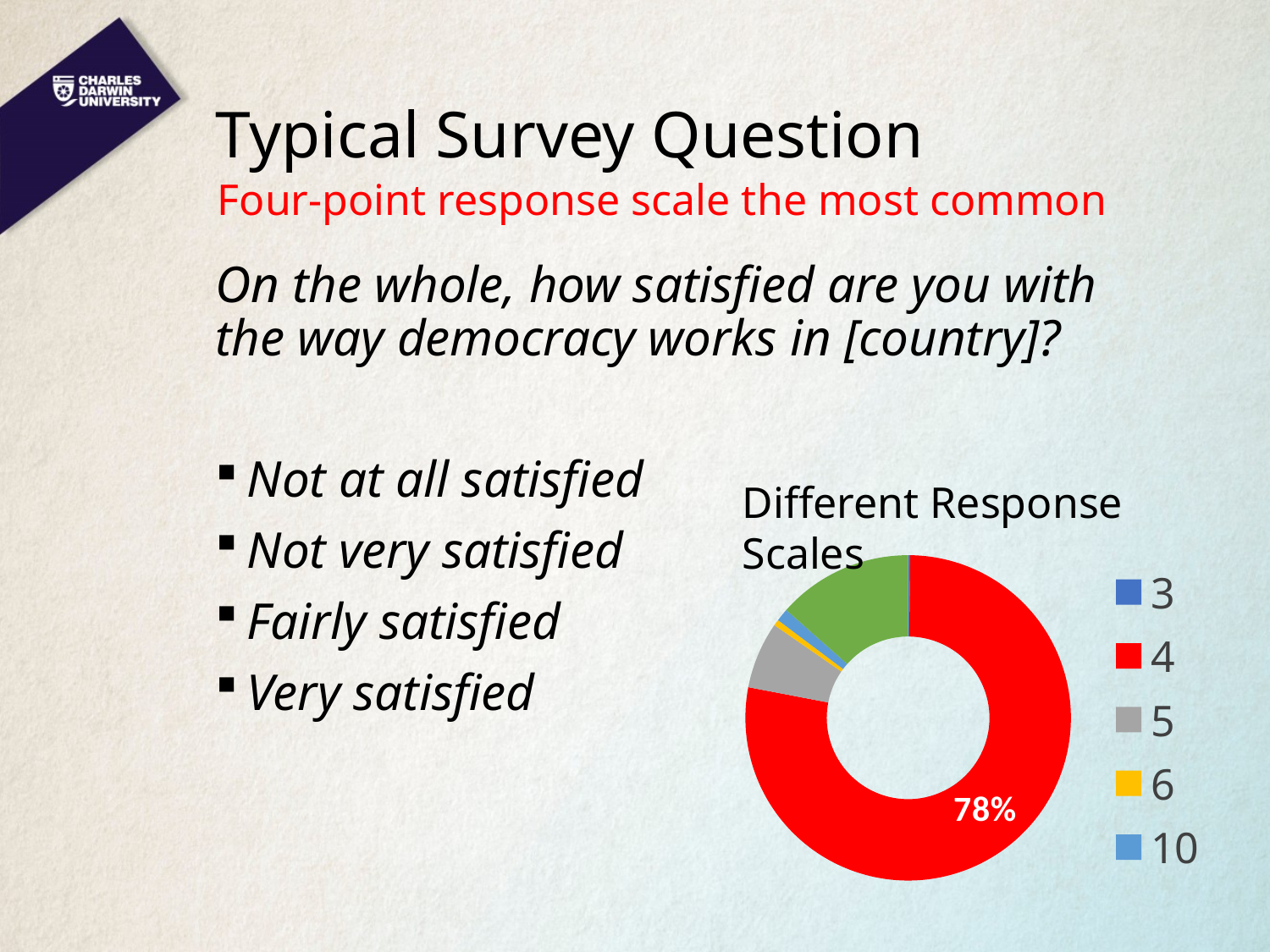
Which response scale has the largest slice in the chart? 4 Which slice is larger in the chart, the one for 4 or the one for 5? 4 What share of the doughnut chart does the response scale 4 account for? 78% Is the share for response scale 4 greater or less than 50%? greater Which slice is larger in the chart, the one for 5 or the one for 6? 5 What kind of chart is shown on the slide? doughnut chart What is the title of the chart? Different Response Scales How many entries does the chart's legend list? 5 What colour represents the response scale 4 in the chart? red